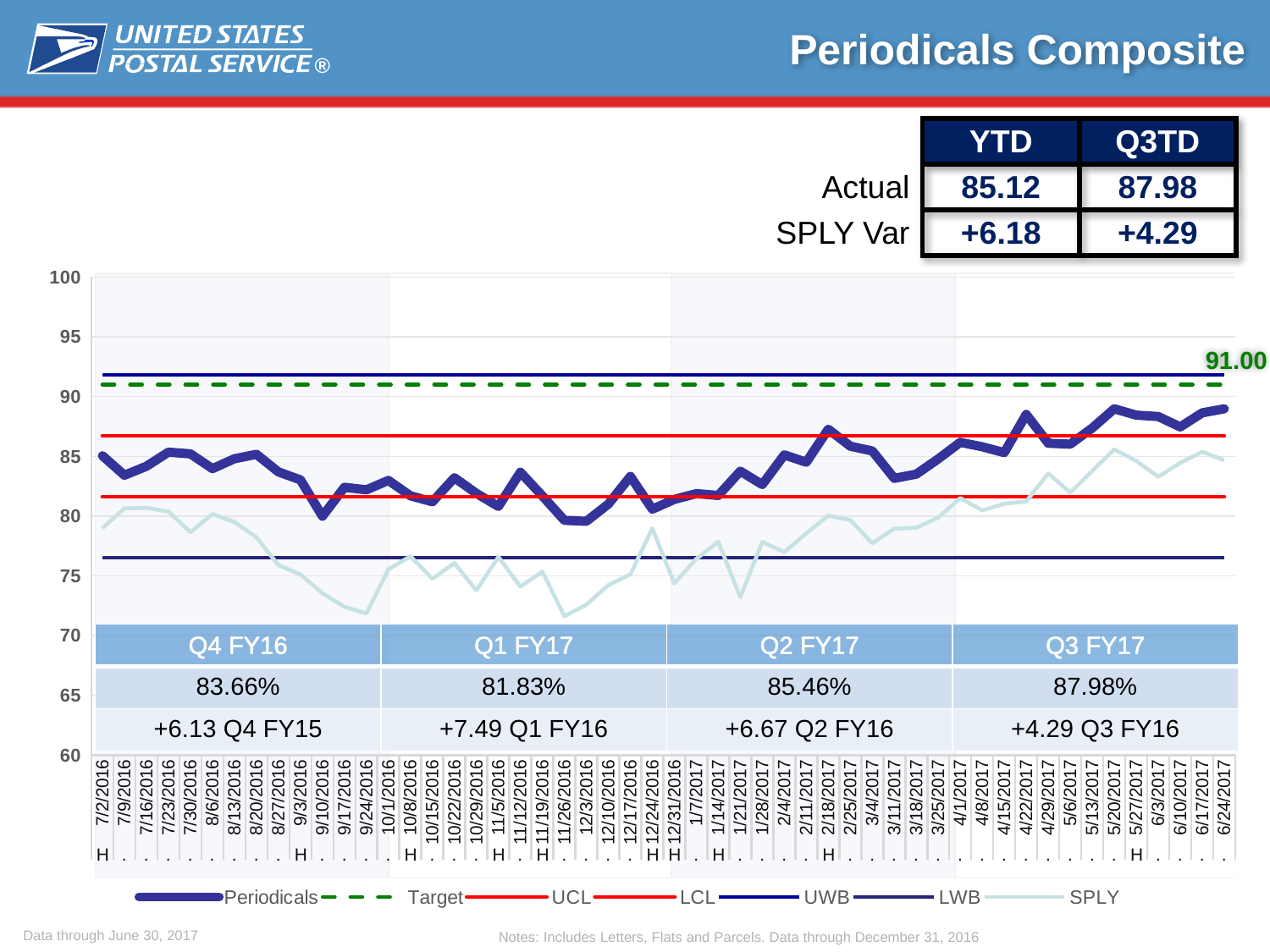
Which quarter in the chart's quarter table has the lowest value? Q1 FY17 Is the Periodicals value on 9/10/2016 greater or less than 85? less Which legend entry is drawn as a green dashed line? Target What value is labelled on the Target line at the right of the chart? 91.00 How many series does the chart legend list? 7 Which is larger, the Q4 FY16 value or the Q2 FY17 value in the quarter table? Q2 FY17 What is the value shown for Q1 FY17 in the quarter table on the chart? 81.83% What is the difference between the Q3 FY17 value and the Q2 FY17 value in the quarter table? 2.52 What type of chart is shown on the slide? line chart Does the Periodicals line generally rise or fall across the Q3 FY17 period (4/1/2017 to 6/24/2017)? rise What is the Periodicals composite value shown for Q3 FY17 in the quarter table on the chart? 87.98% Which quarter in the chart's quarter table has the highest value? Q3 FY17